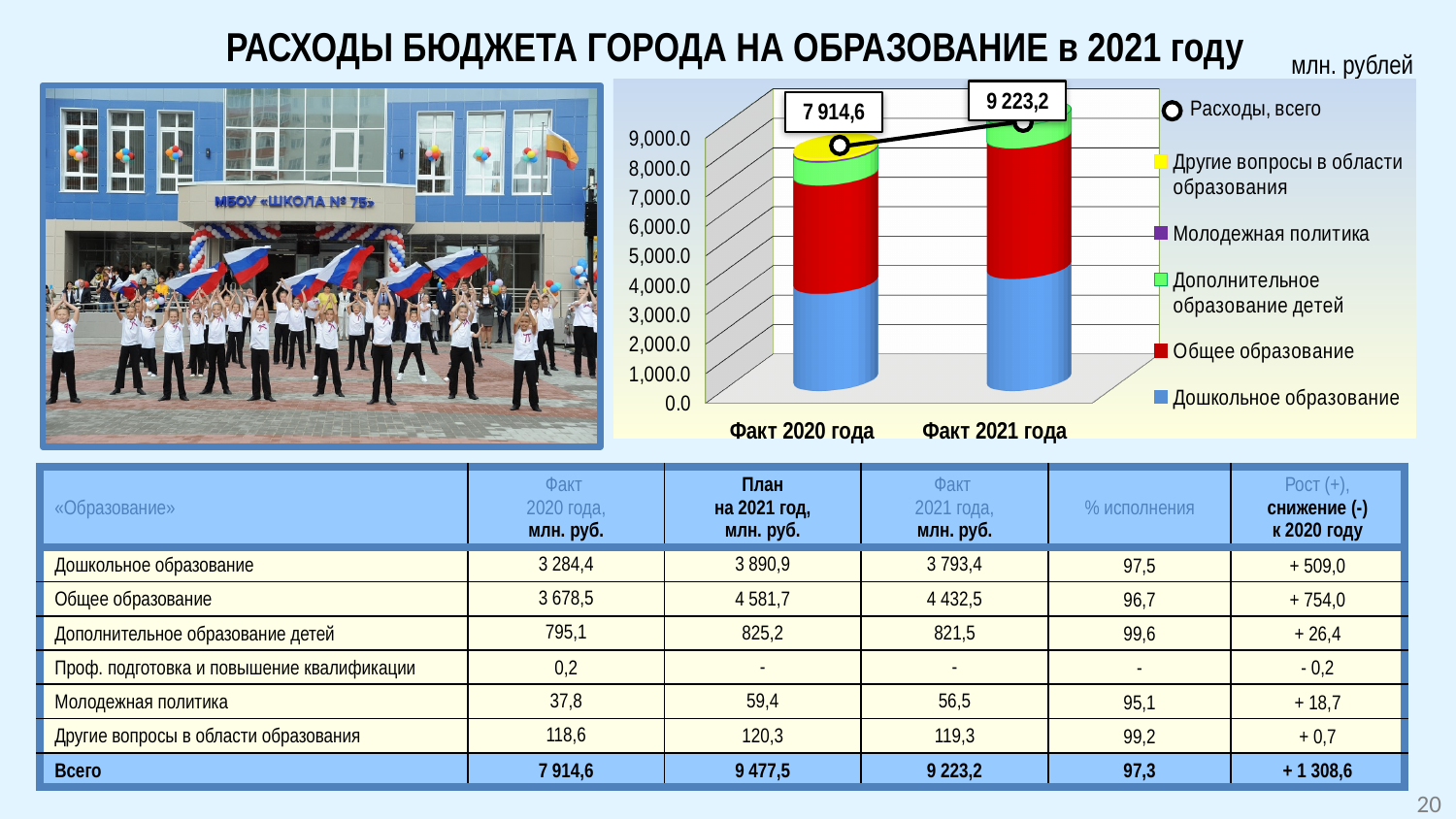
Which category has the highest value of Расходы, всего? Факт 2021 года Is the value of Расходы, всего for Факт 2021 года greater or less than 9,000.0? greater Which is larger for Расходы, всего: Факт 2020 года or Факт 2021 года? Факт 2021 года What kind of chart is shown on the slide? Stacked bar chart with a line Which category has the lowest value of Расходы, всего? Факт 2020 года Does Расходы, всего rise or fall from Факт 2020 года to Факт 2021 года? Rise What unit is indicated for the chart values? млн. рублей What is the value of Расходы, всего for Факт 2021 года? 9 223,2 What is the value of Расходы, всего for Факт 2020 года? 7 914,6 By how much does Расходы, всего for Факт 2021 года exceed Факт 2020 года? 1 308,6 How many categories are shown on the x axis of the chart? 2 How many entries does the chart legend list? 6